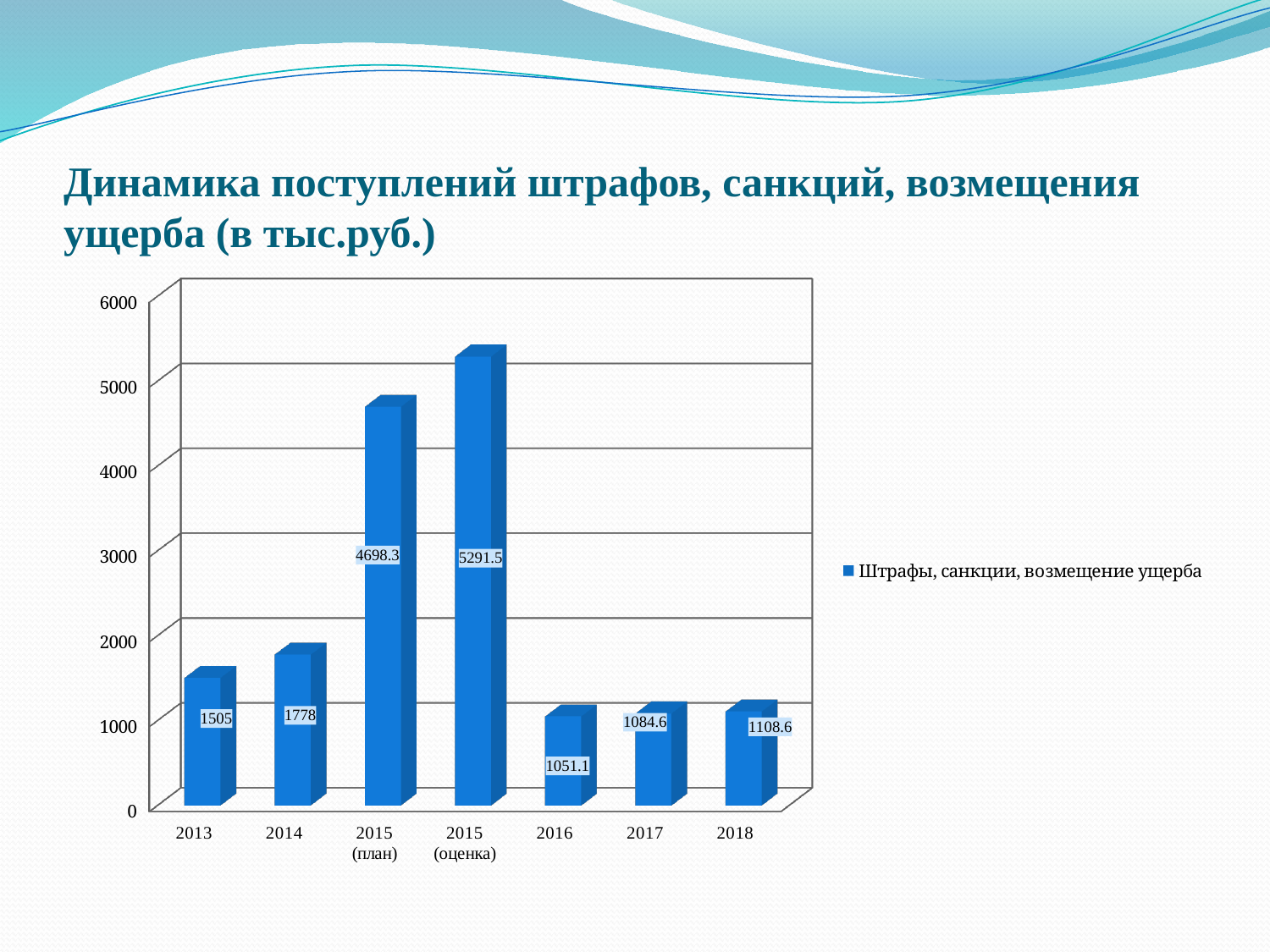
Is the value for 2015 (план) greater or less than 4000? greater What is the value for 2013? 1505 What is the value for 2017? 1084.6 What is the value for 2015 (оценка)? 5291.5 Which category has the lowest value? 2016 What kind of chart is shown on the slide? bar chart Which category has the highest value? 2015 (оценка) How many categories are shown on the x axis? 7 How many series does the legend list? 1 What is the legend entry for the series? Штрафы, санкции, возмещение ущерба What is the difference between the values for 2015 (оценка) and 2015 (план)? 593.2 Which is larger, the value for 2014 or the value for 2018? 2014